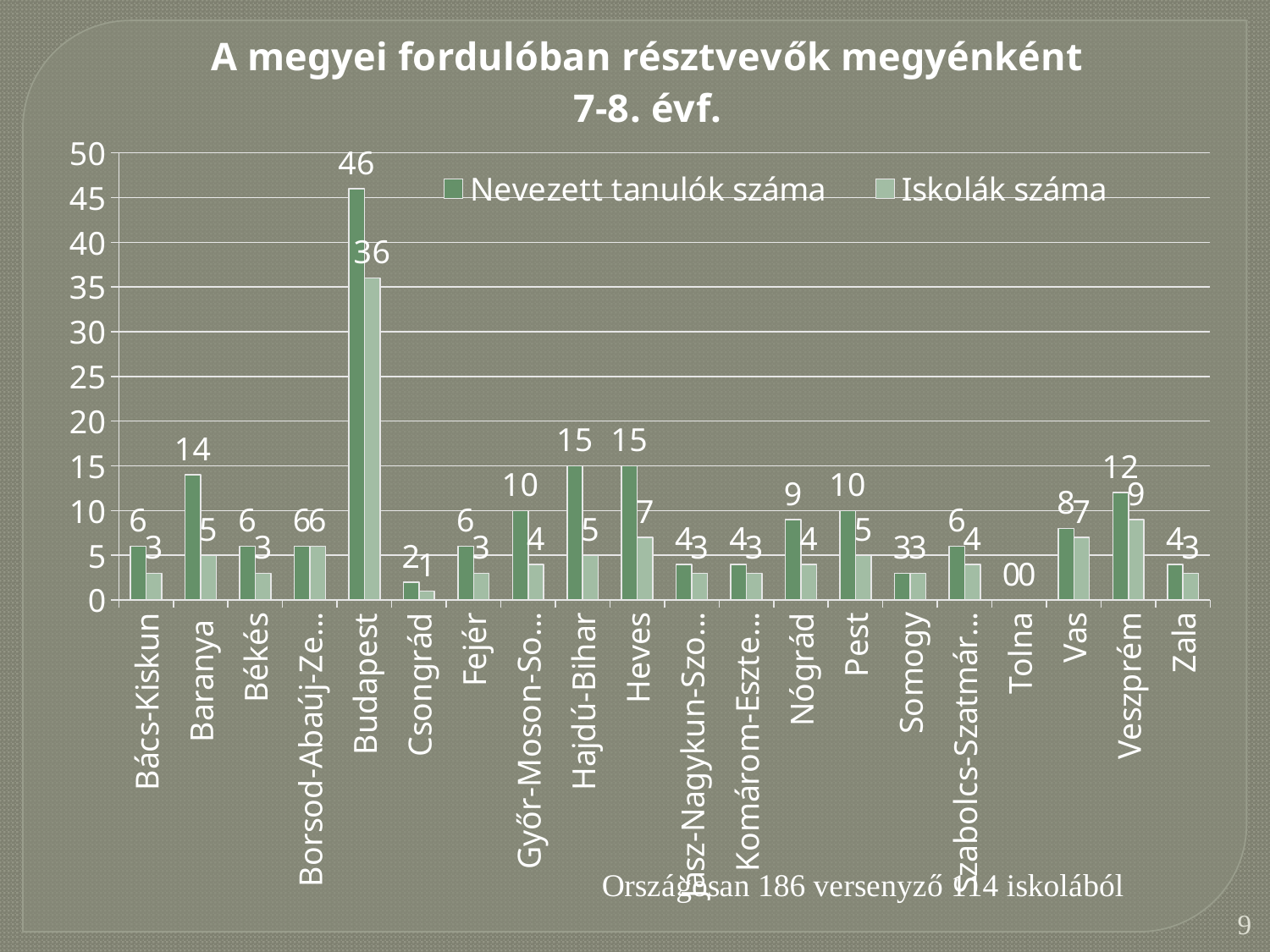
What type of chart is shown on the slide? bar chart What is the value of Nevezett tanulók száma for Baranya? 14 Which county has the highest value for Nevezett tanulók száma? Budapest How many series does the legend list? 2 What is the title of the chart? A megyei fordulóban résztvevők megyénként 7-8. évf. What is the value of Nevezett tanulók száma for Budapest? 46 How many counties (categories) are shown on the x axis? 20 What is the value of Iskolák száma for Veszprém? 9 What is the difference between Nevezett tanulók száma and Iskolák száma for Heves? 8 What is the value of Iskolák száma for Budapest? 36 Which is larger: Nevezett tanulók száma for Pest or for Nógrád? Pest Which county has the lowest value for Iskolák száma? Tolna